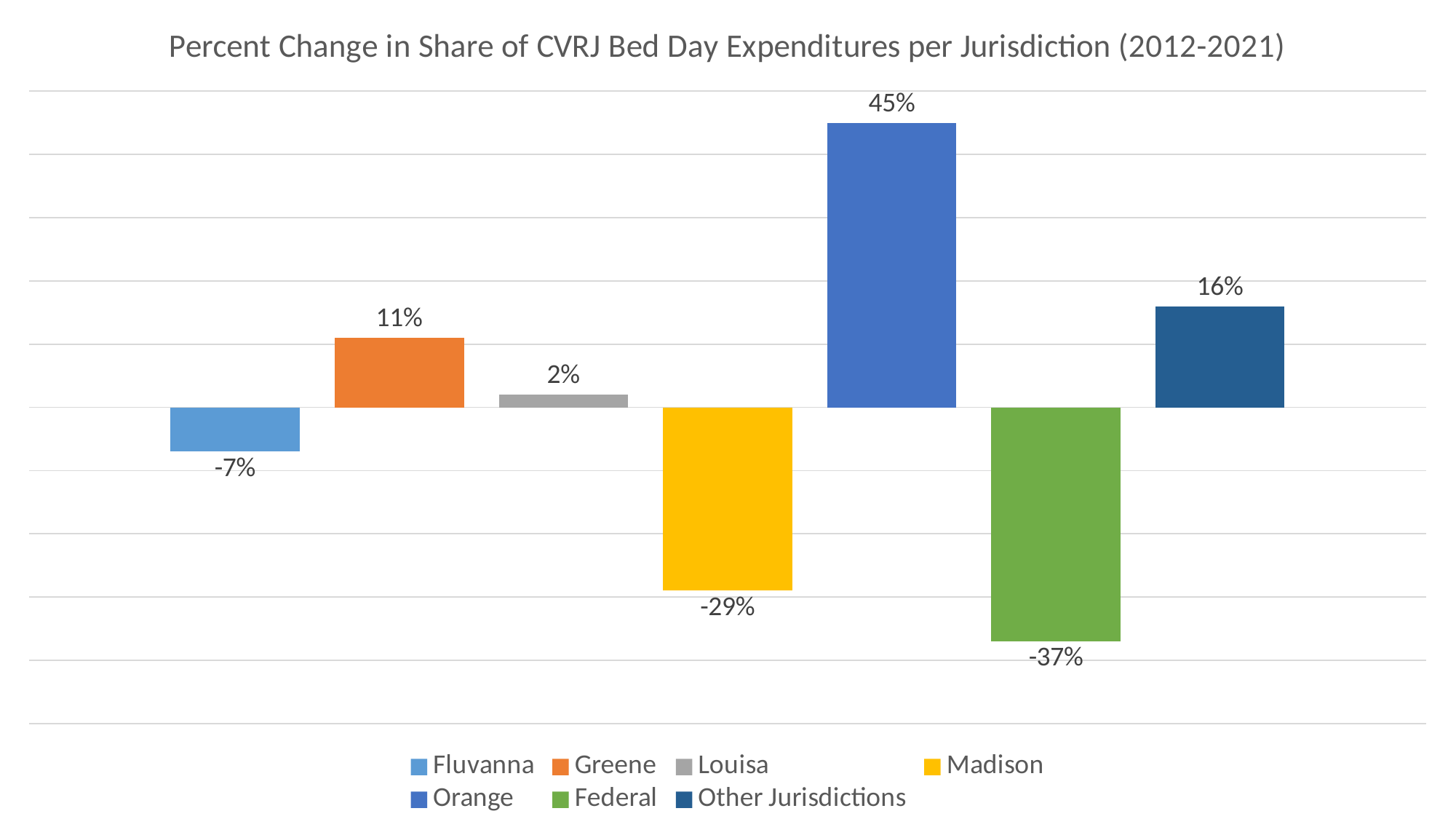
How many entries does the legend list? 7 What is the percent change for Madison? -29% What type of chart is shown? Bar chart Which has a larger percent change, Greene or Louisa? Greene What colour is the bar for Madison? Yellow What is the difference between the percent change for Orange and for Greene? 34 percentage points How many jurisdictions are shown in the chart? 7 What is the percent change for Fluvanna? -7% Which jurisdiction has the highest percent change? Orange What is the percent change for Orange? 45% What is the percent change for Other Jurisdictions? 16% Which jurisdiction has the lowest percent change? Federal